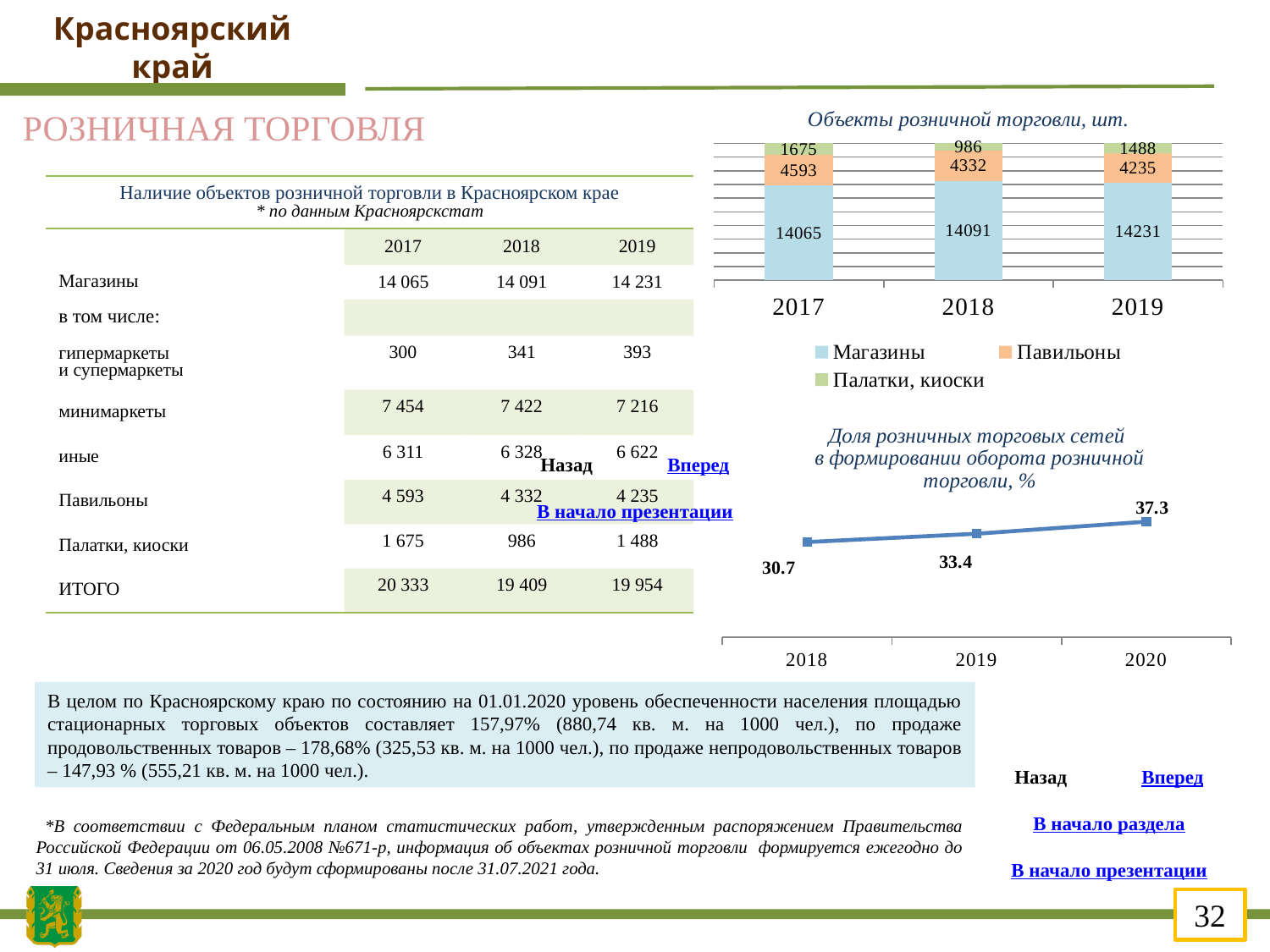
In the chart 'Доля розничных торговых сетей в формировании оборота розничной торговли, %', what is the value for 2019? 33.4 In the chart 'Объекты розничной торговли, шт.', what is the value for Магазины in 2019? 14231 In the chart 'Объекты розничной торговли, шт.', how many series does the legend list? 3 In the chart 'Объекты розничной торговли, шт.', what is the value for Павильоны in 2018? 4332 What kind of chart is 'Объекты розничной торговли, шт.'? Stacked bar chart In the chart 'Объекты розничной торговли, шт.', what is the total of the stacked bar for 2018? 19409 In the chart 'Объекты розничной торговли, шт.', which year has the lowest value for Палатки, киоски? 2018 In the chart 'Доля розничных торговых сетей в формировании оборота розничной торговли, %', what is the difference between the 2020 and 2018 values? 6.6 In the chart 'Объекты розничной торговли, шт.', what is the difference between the Павильоны values for 2017 and 2019? 358 In the chart 'Объекты розничной торговли, шт.', what is the value for Палатки, киоски in 2017? 1675 In the chart 'Доля розничных торговых сетей в формировании оборота розничной торговли, %', which year has the highest value? 2020 In the chart 'Доля розничных торговых сетей в формировании оборота розничной торговли, %', do the values rise or fall from 2018 to 2020? Rise